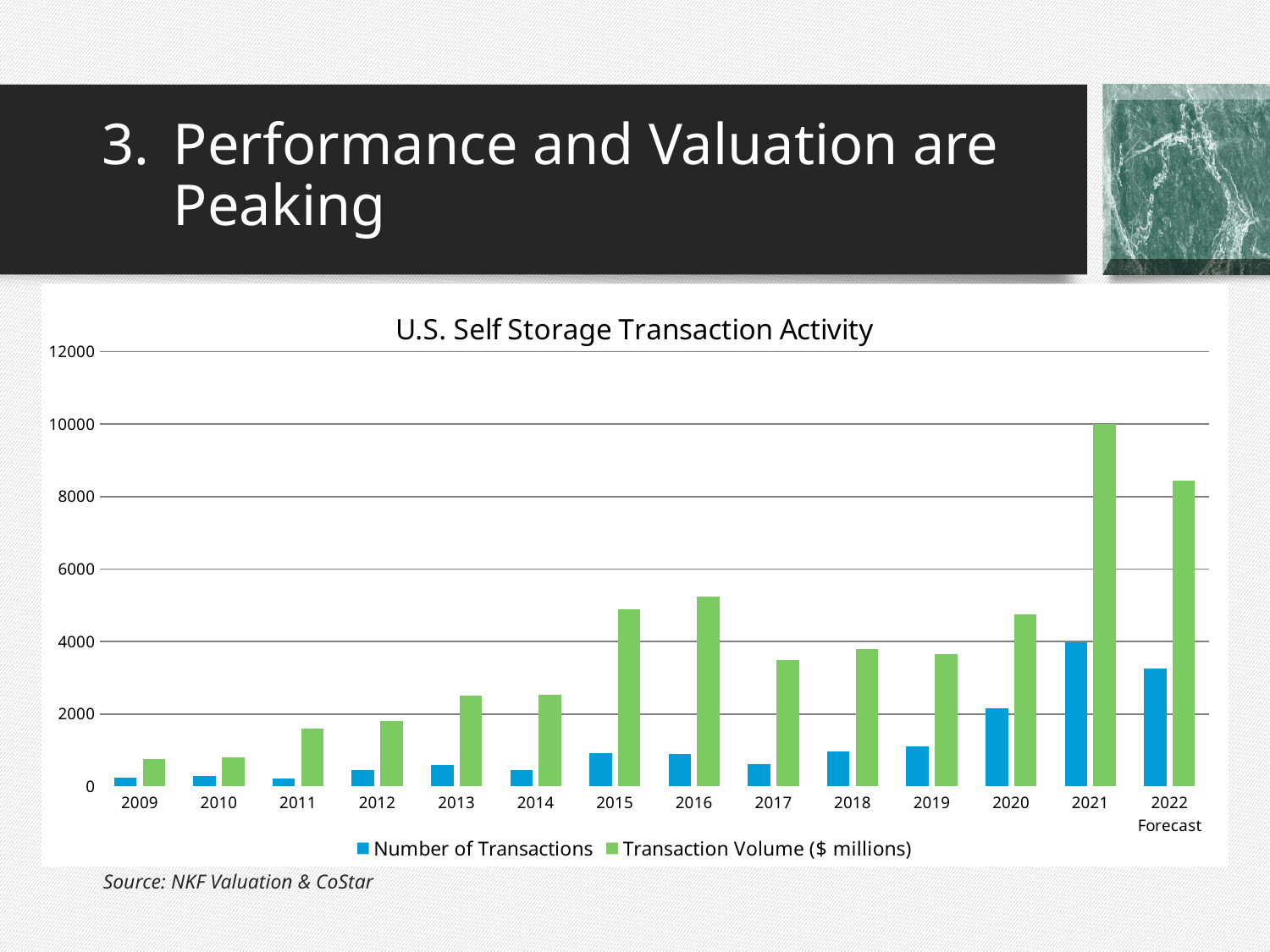
Which is larger, the Transaction Volume ($ millions) for 2021 or for 2022 Forecast? 2021 Which year has the highest Number of Transactions? 2021 What kind of chart is shown on the slide? Bar chart Is the Transaction Volume ($ millions) for 2016 greater or less than 4000? greater Is the Number of Transactions for 2022 Forecast greater or less than 4000? less How many series does the legend list? 2 What is the title of the chart? U.S. Self Storage Transaction Activity Which year has the highest Transaction Volume ($ millions)? 2021 How many years (categories) are shown on the x axis? 14 Does the Transaction Volume ($ millions) generally rise or fall from 2009 to 2021? rise Is the Transaction Volume ($ millions) for 2017 greater or less than 4000? less